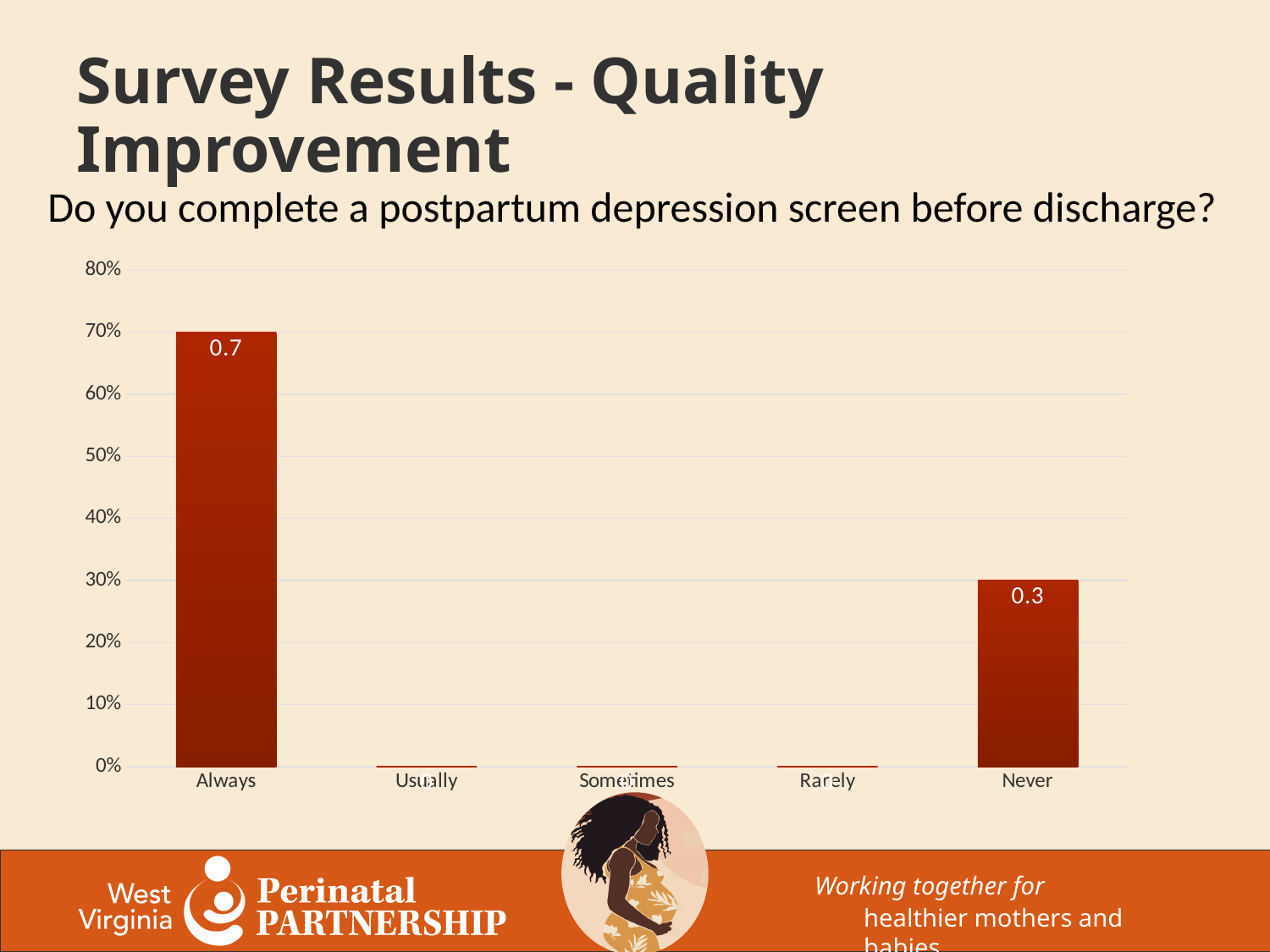
What is the value shown for the Always bar? 0.7 Is the value for Always greater or less than 60%? greater What is the highest value shown on the y axis? 80% What kind of chart is shown on the slide? bar chart Which is larger, the value for Always or the value for Never? Always What survey question does the chart present results for? Do you complete a postpartum depression screen before discharge? What is the difference between the labelled values for Always and Never? 0.4 Is the value for Never greater or less than 40%? less What is the value shown for the Never bar? 0.3 How many categories are shown on the x axis? 5 Which category has the highest bar? Always Is the value for Usually greater or less than 10%? less